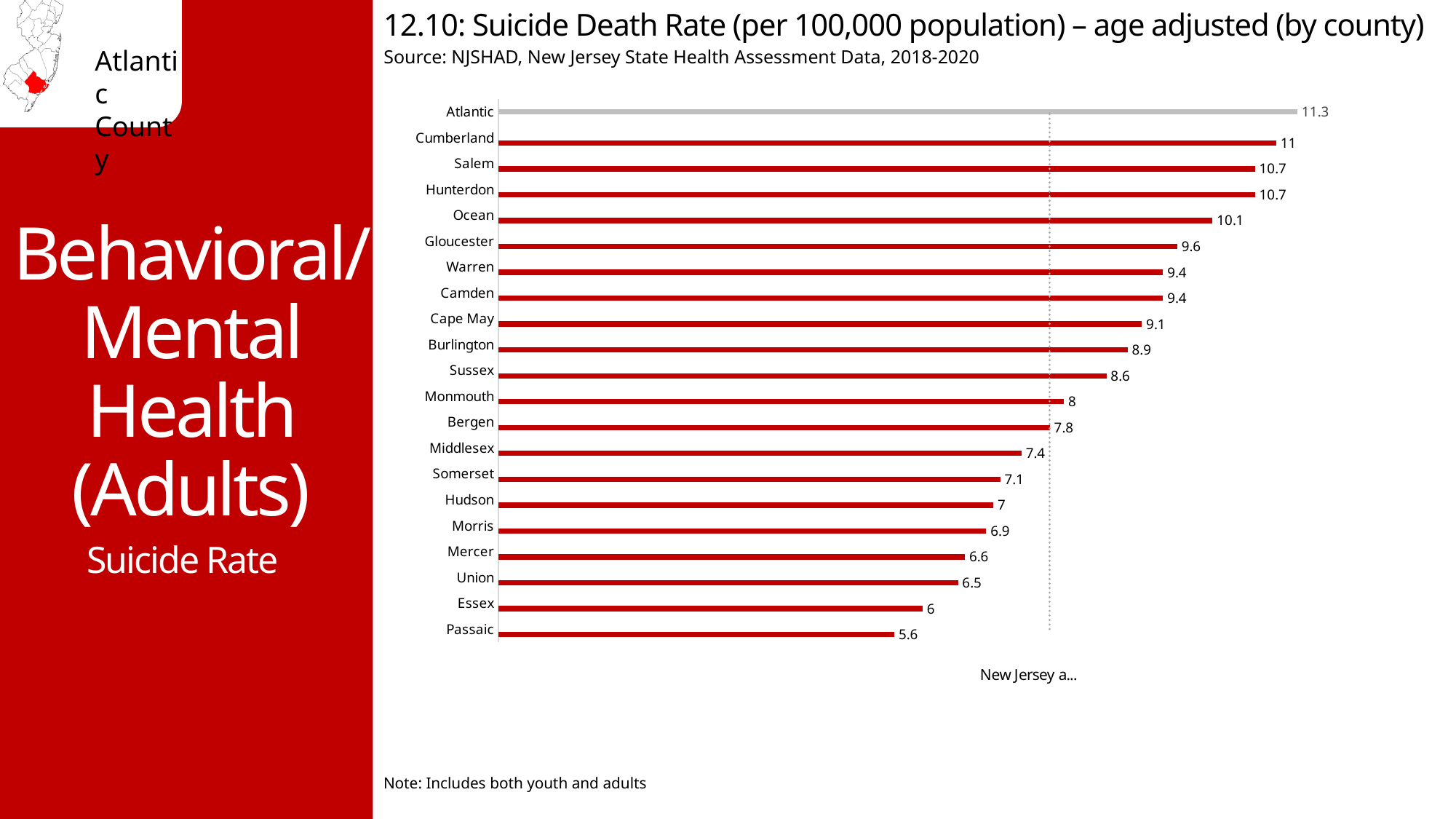
How many counties are shown in the chart? 21 What type of chart is used on this slide? Bar chart What is the source of the data shown in the chart? NJSHAD, New Jersey State Health Assessment Data, 2018-2020 What is the difference between the suicide death rates of Ocean and Essex counties? 4.1 What is the suicide death rate for Atlantic County? 11.3 Which county has the lowest suicide death rate? Passaic Which county has a higher suicide death rate, Mercer or Sussex? Sussex Which county has the highest suicide death rate? Atlantic What is the difference between the suicide death rates of Atlantic and Cumberland counties? 0.3 What is the suicide death rate for Gloucester County? 9.6 Which county has a higher suicide death rate, Bergen or Middlesex? Bergen What is the suicide death rate for Passaic County? 5.6